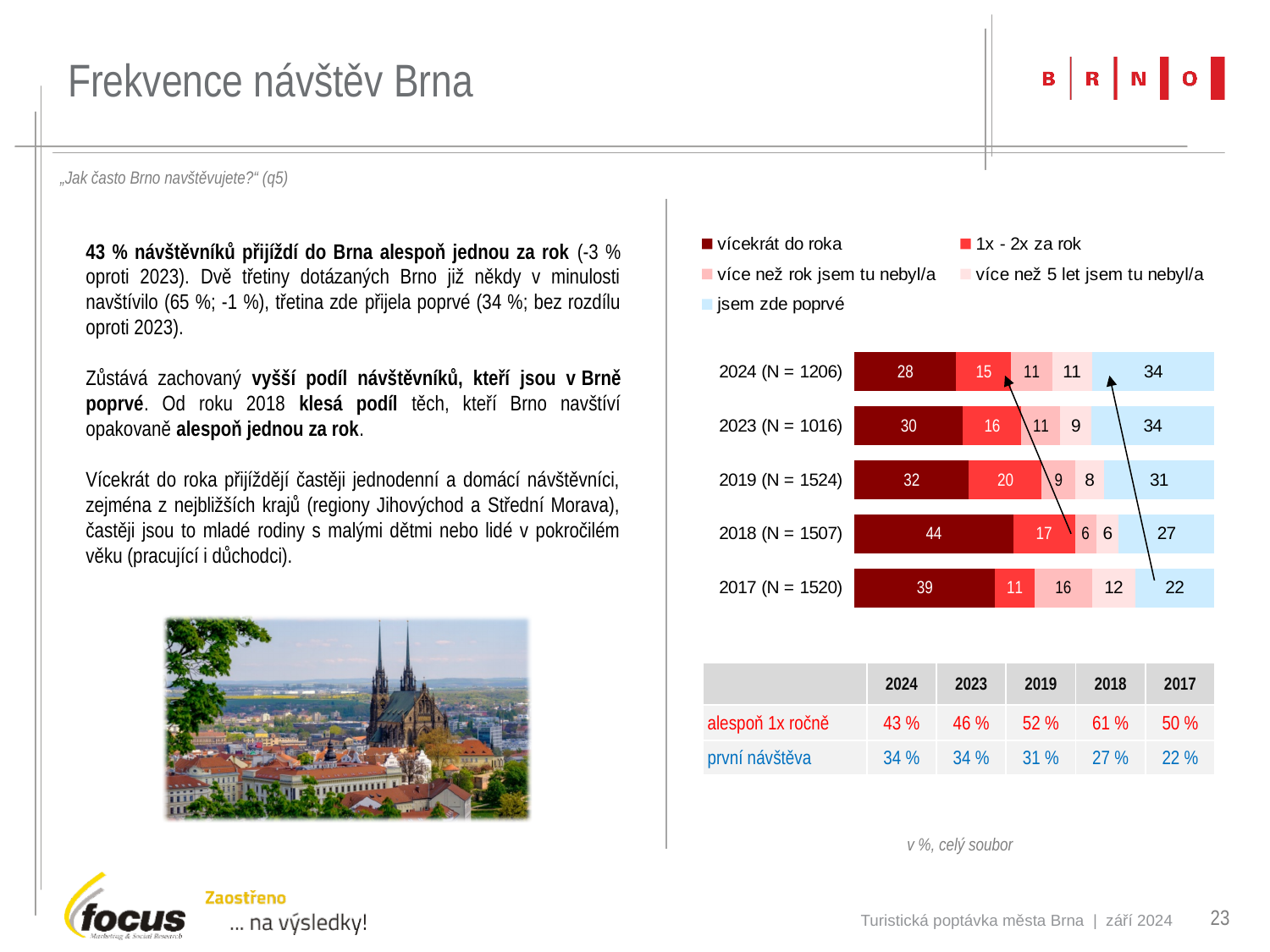
Does the 'jsem zde poprvé' value rise or fall from 2017 to 2024 (reading the bars from bottom to top)? rise What type of chart is shown on the slide? stacked bar chart Which year has the lowest value for 'jsem zde poprvé'? 2017 (N = 1520) What is the difference between the 'vícekrát do roka' values for 2018 (N = 1507) and 2024 (N = 1206)? 16 Which year has the highest value for 'vícekrát do roka'? 2018 (N = 1507) How many year categories are plotted in the chart? 5 What is the value for 'jsem zde poprvé' in 2017 (N = 1520)? 22 What is the total of the stacked bar for 2023 (N = 1016)? 100 Which is larger: 'více než 5 let jsem tu nebyl/a' in 2017 (N = 1520) or in 2018 (N = 1507)? 2017 (N = 1520) What is the value for '1x - 2x za rok' in 2019 (N = 1524)? 20 What is the value for 'vícekrát do roka' in 2024 (N = 1206)? 28 How many series does the chart legend list? 5